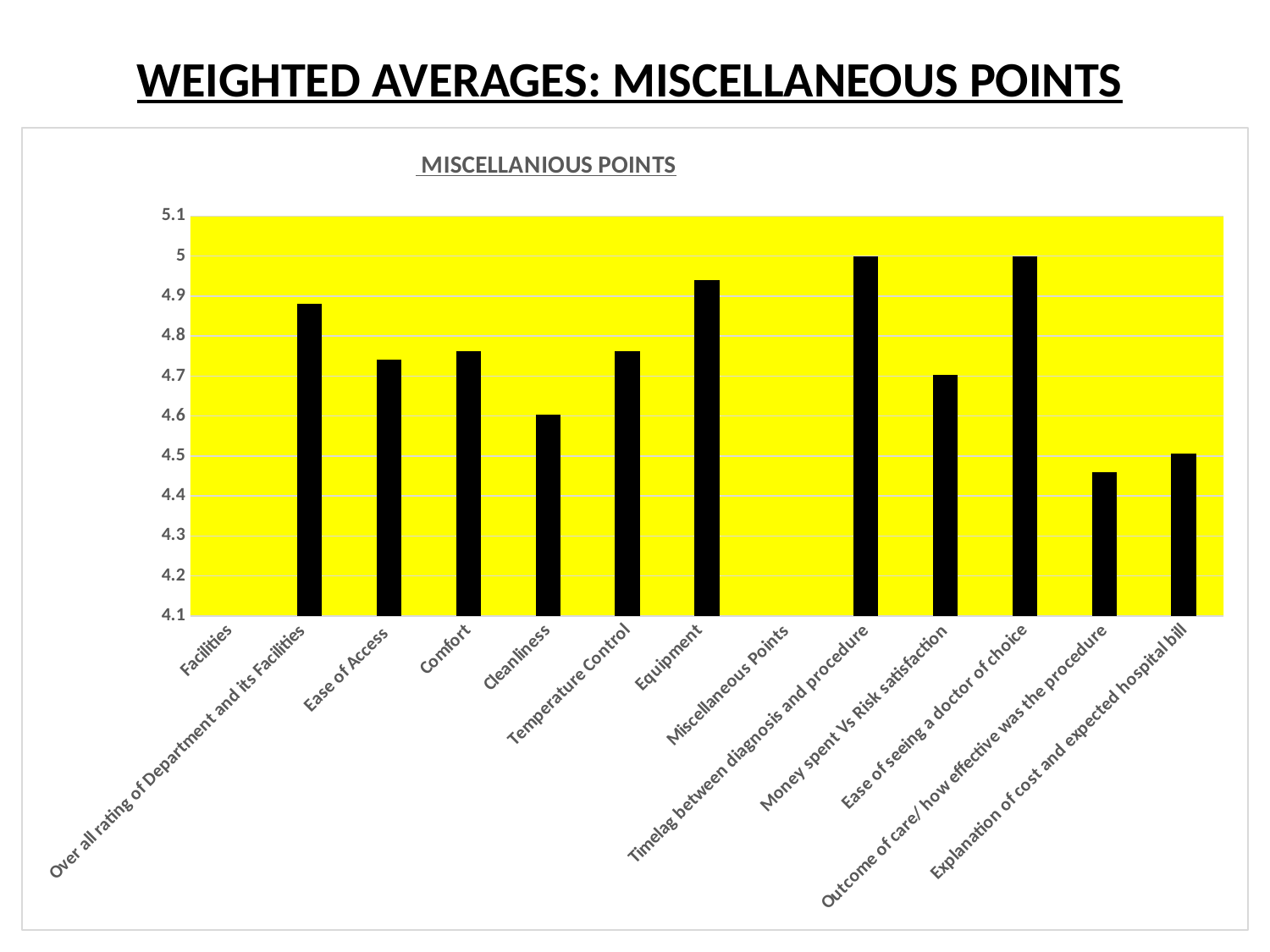
What type of chart is shown on the slide? bar chart Which has the lowest value among the plotted bars? Outcome of care/ how effective was the procedure Is the value for Equipment greater or less than 4.9? greater Which is larger, the value for Ease of Access or the value for Over all rating of Department and its Facilities? Over all rating of Department and its Facilities What is the value for Timelag between diagnosis and procedure? 5 Is the value for Outcome of care/ how effective was the procedure greater or less than 4.5? less How many bars are plotted in the chart? 11 Is the value for Over all rating of Department and its Facilities greater or less than 4.9? less What is the title shown inside the chart area? MISCELLANIOUS POINTS Which is larger, the value for Equipment or the value for Comfort? Equipment